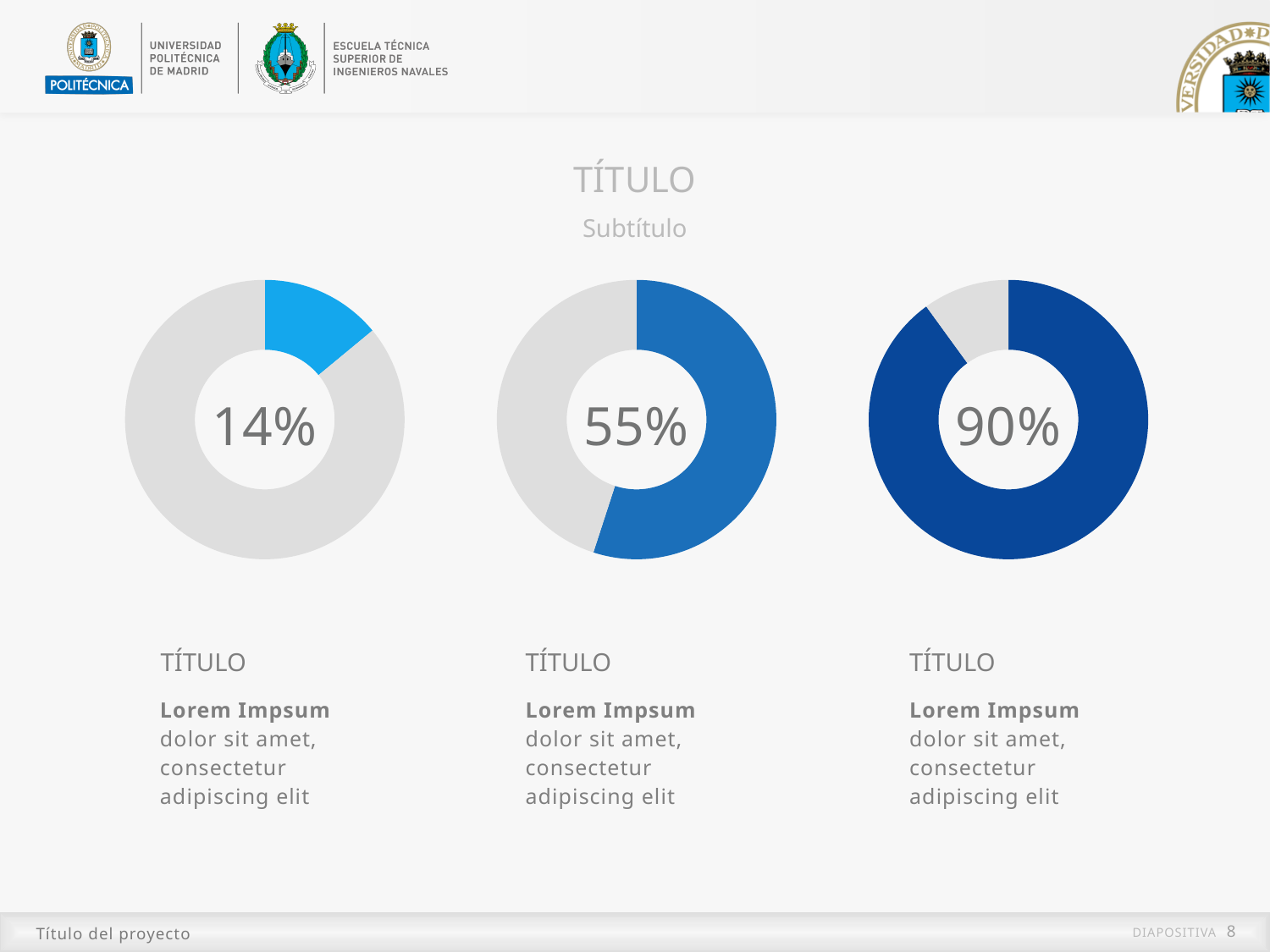
What percentage is shown in the centre of the left donut chart? 14% What percentage is shown in the centre of the middle donut chart? 55% What is the difference between the percentage in the right donut chart and the percentage in the left donut chart? 76% In the middle donut chart, what share of the ring is filled with blue? 55% What percentage is shown in the centre of the right donut chart? 90% Which donut chart (left, middle or right) shows the highest percentage? Right Which donut chart (left, middle or right) shows the lowest percentage? Left What is the difference between the percentage in the middle donut chart and the percentage in the left donut chart? 41% Which is larger, the percentage in the middle donut chart or the percentage in the right donut chart? Right (90%) What kind of chart is used for the three figures on the slide? Donut chart How many donut charts are on the slide? 3 Do the percentages increase or decrease from the left donut chart to the right donut chart? Increase